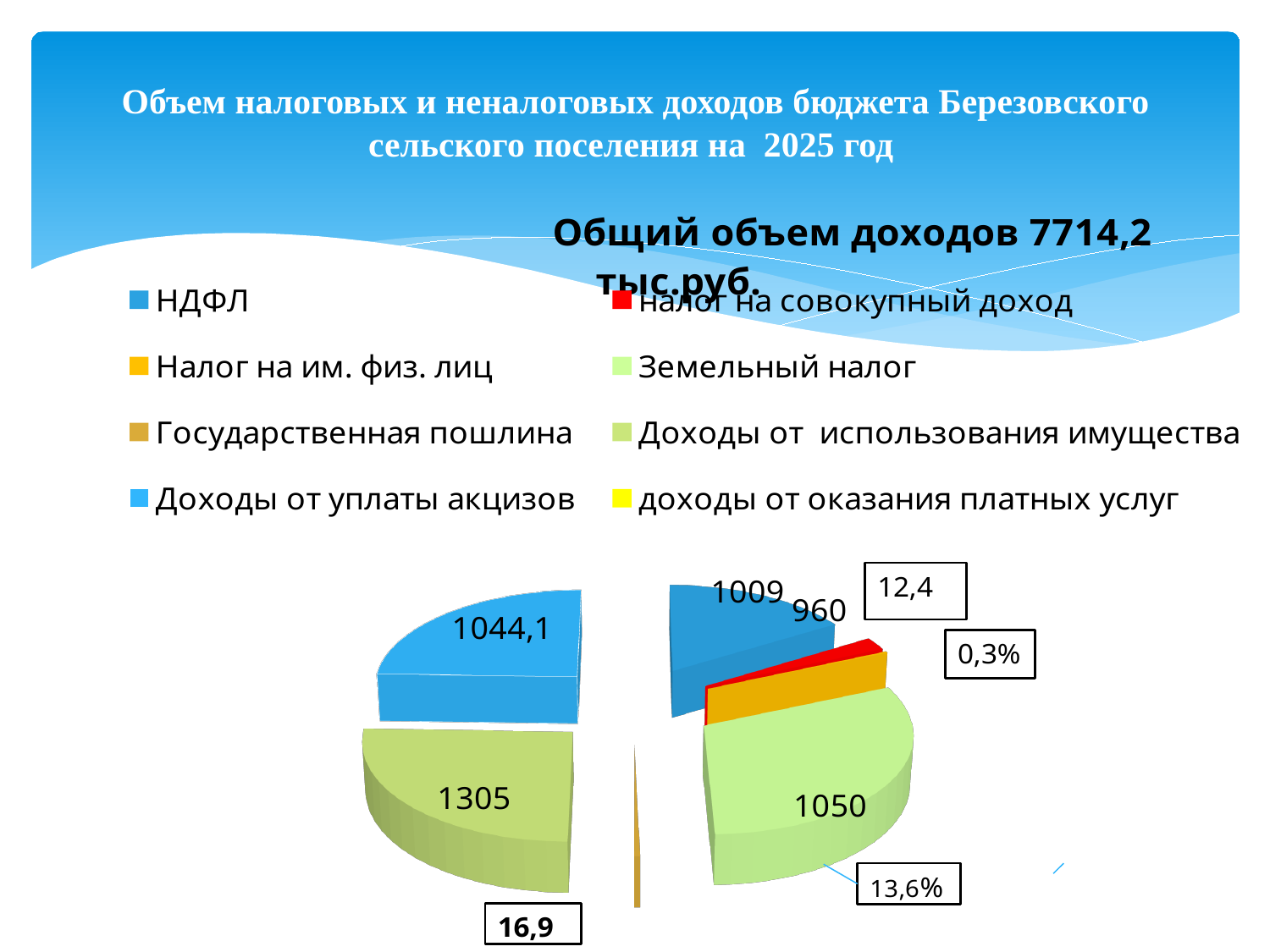
Which category has the largest labelled value on the pie chart? Доходы от использования имущества What percentage label is shown next to the light green slice labelled 1050? 13,6% What value is shown in the box below the thin slice at the bottom centre of the pie? 16,9 What is the difference between the values for Доходы от использования имущества (1305) and Земельный налог (1050)? 255 What total revenue amount is stated above the chart? 7714,2 тыс.руб. Which is larger: Доходы от использования имущества or Земельный налог? Доходы от использования имущества How many entries does the chart legend list? 8 What kind of chart is shown on the slide? pie chart What colour is used in the legend for налог на совокупный доход? red What is the value shown for Земельный налог? 1050 What is the value shown for Доходы от использования имущества? 1305 What is the difference between the slice labelled 1305 and the slice labelled 1044,1? 260,9